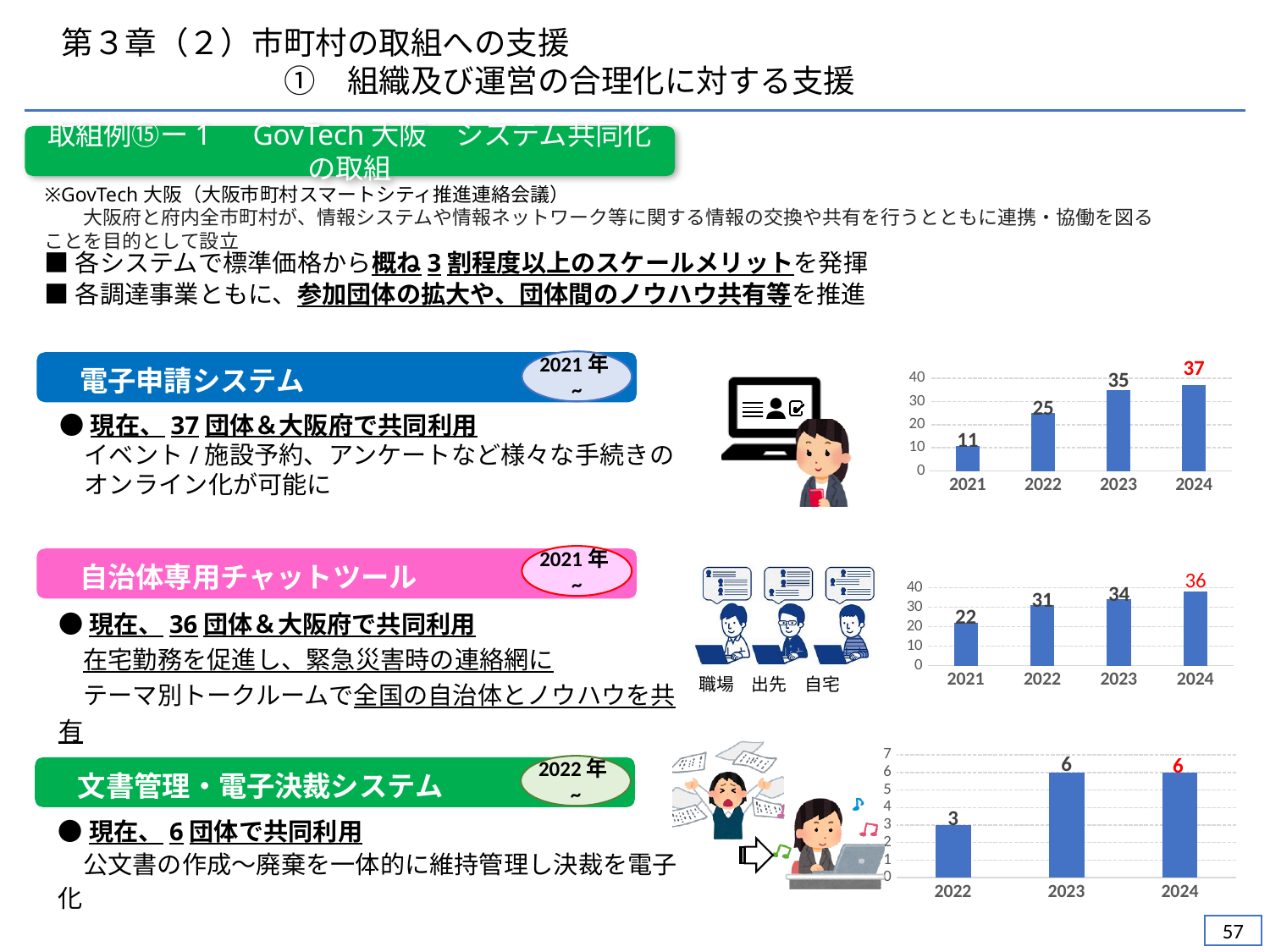
In the middle-right chart (自治体専用チャットツール), what is the difference between the 2024 and 2021 values? 14 In the middle-right chart (自治体専用チャットツール), what is the value for 2022? 31 In the bottom-right chart (文書管理・電子決裁システム), how many years are plotted? 3 In the middle-right chart (自治体専用チャットツール), which year has the highest value? 2024 In the bottom-right chart (文書管理・電子決裁システム), what is the value for 2022? 3 In the top-right chart (電子申請システム), what is the difference between the 2022 and 2021 values? 14 What type of chart is the bottom-right chart (文書管理・電子決裁システム)? bar chart In the top-right chart (電子申請システム), what is the value for 2021? 11 In the top-right chart (電子申請システム), what is the value for 2024? 37 In the top-right chart (電子申請システム), do the values rise or fall from 2021 to 2024? rise In the top-right chart (電子申請システム), which year has the lowest value? 2021 In the middle-right chart (自治体専用チャットツール), how many years are plotted? 4